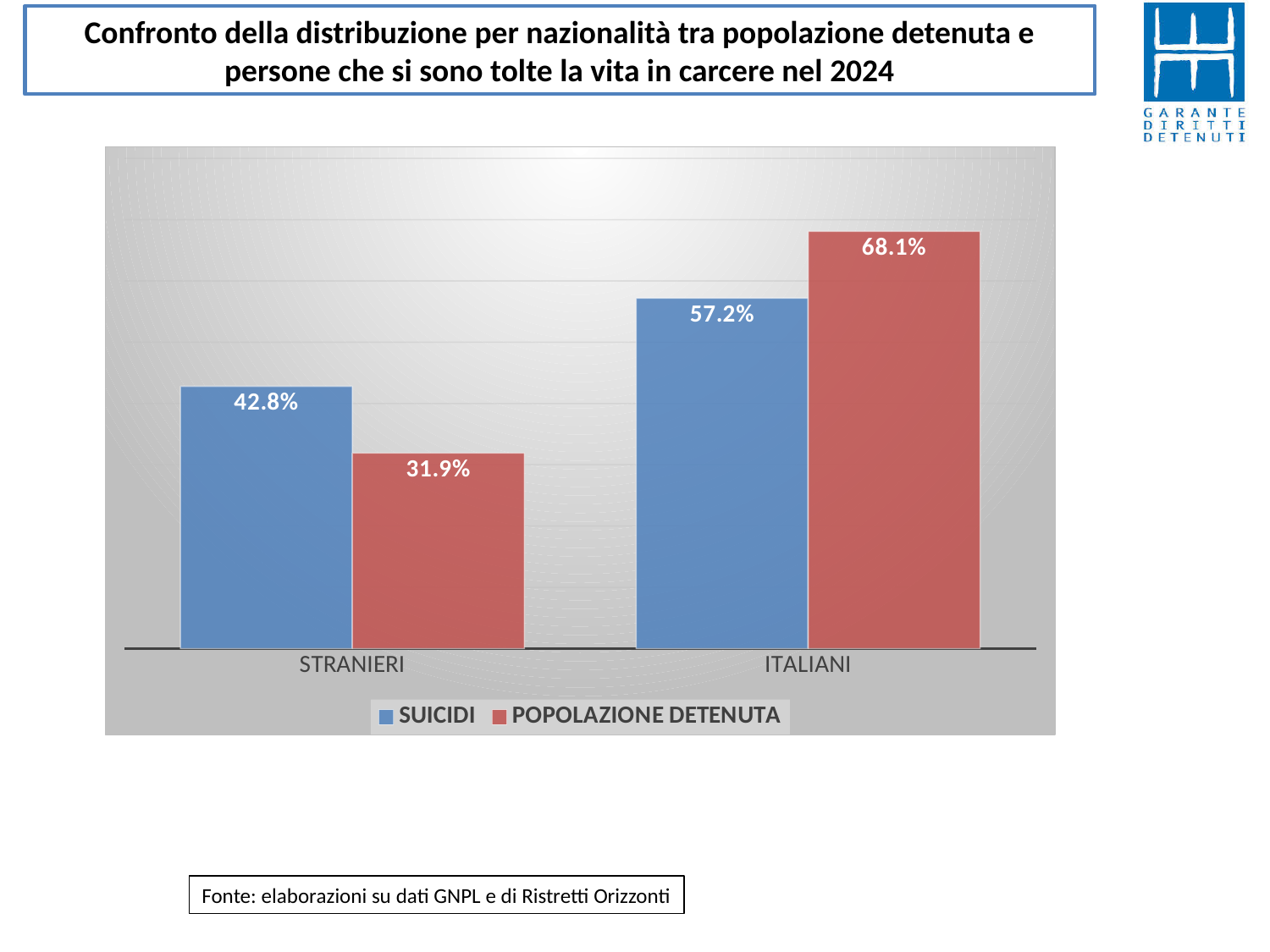
What is the difference between the POPOLAZIONE DETENUTA and SUICIDI values for ITALIANI? 10.9% What kind of chart is shown on the slide? Bar chart What is the difference between the SUICIDI and POPOLAZIONE DETENUTA values for STRANIERI? 10.9% What is the SUICIDI value for STRANIERI? 42.8% What is the POPOLAZIONE DETENUTA value for STRANIERI? 31.9% What is the SUICIDI value for ITALIANI? 57.2% Which category has the lowest SUICIDI value? STRANIERI How many categories are shown on the x axis? 2 How many series does the legend list? 2 For ITALIANI, which is larger: SUICIDI or POPOLAZIONE DETENUTA? POPOLAZIONE DETENUTA What is the POPOLAZIONE DETENUTA value for ITALIANI? 68.1% Which category has the highest POPOLAZIONE DETENUTA value? ITALIANI